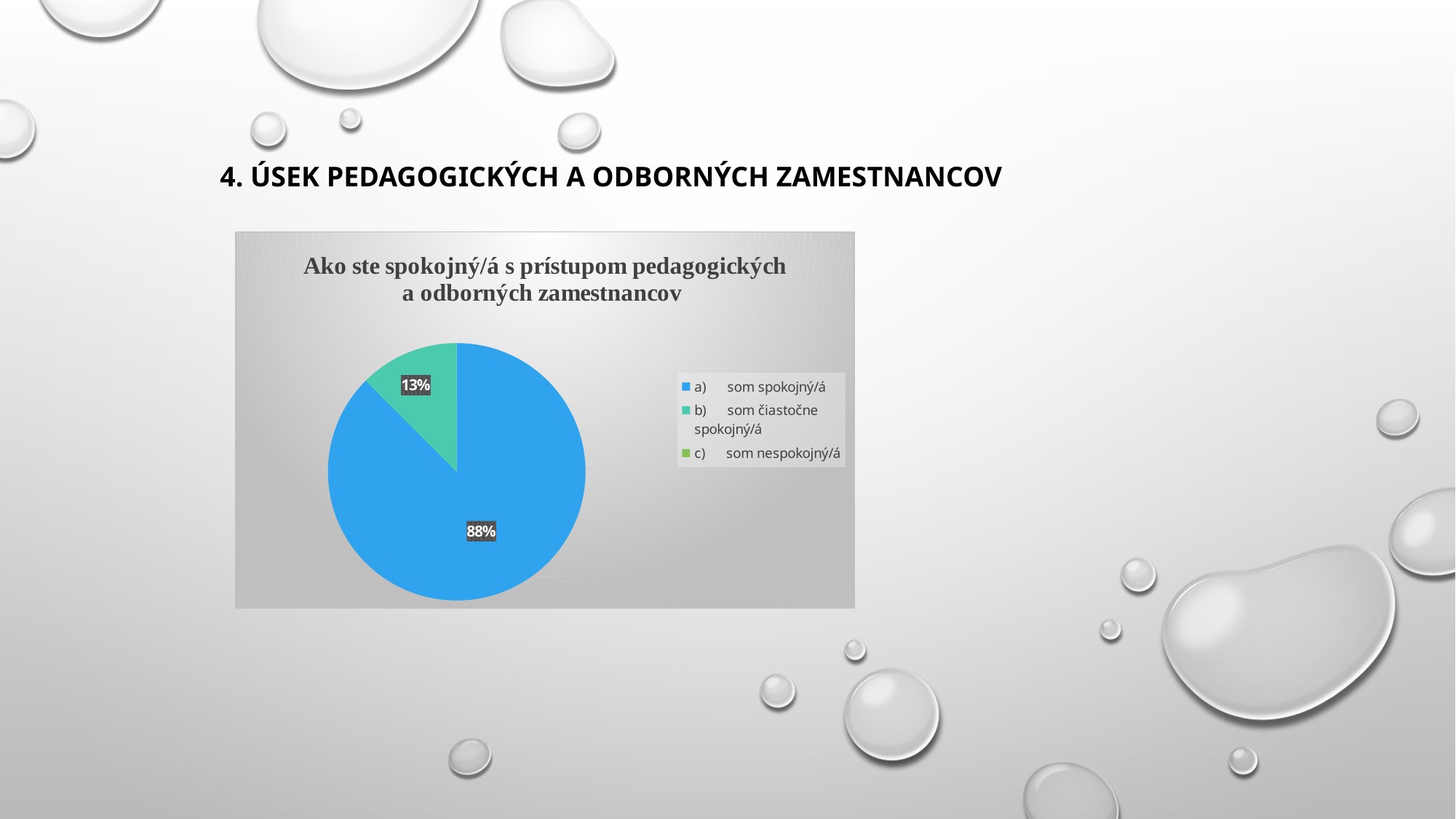
What share of the pie is labelled for "b) som čiastočne spokojný/á"? 13% What is the title of the chart? Ako ste spokojný/á s prístupom pedagogických a odborných zamestnancov What is the difference in percentage points between the "a) som spokojný/á" slice and the "b) som čiastočne spokojný/á" slice? 75 What share of the pie is labelled for "a) som spokojný/á"? 88% What colour is the slice for "a) som spokojný/á"? blue What type of chart is shown on the slide? pie chart Which category has the largest slice of the pie? a) som spokojný/á How many slices with data labels are visible in the pie? 2 How many entries does the legend list? 3 Which of the two labelled slices is larger: "a) som spokojný/á" or "b) som čiastočne spokojný/á"? a) som spokojný/á